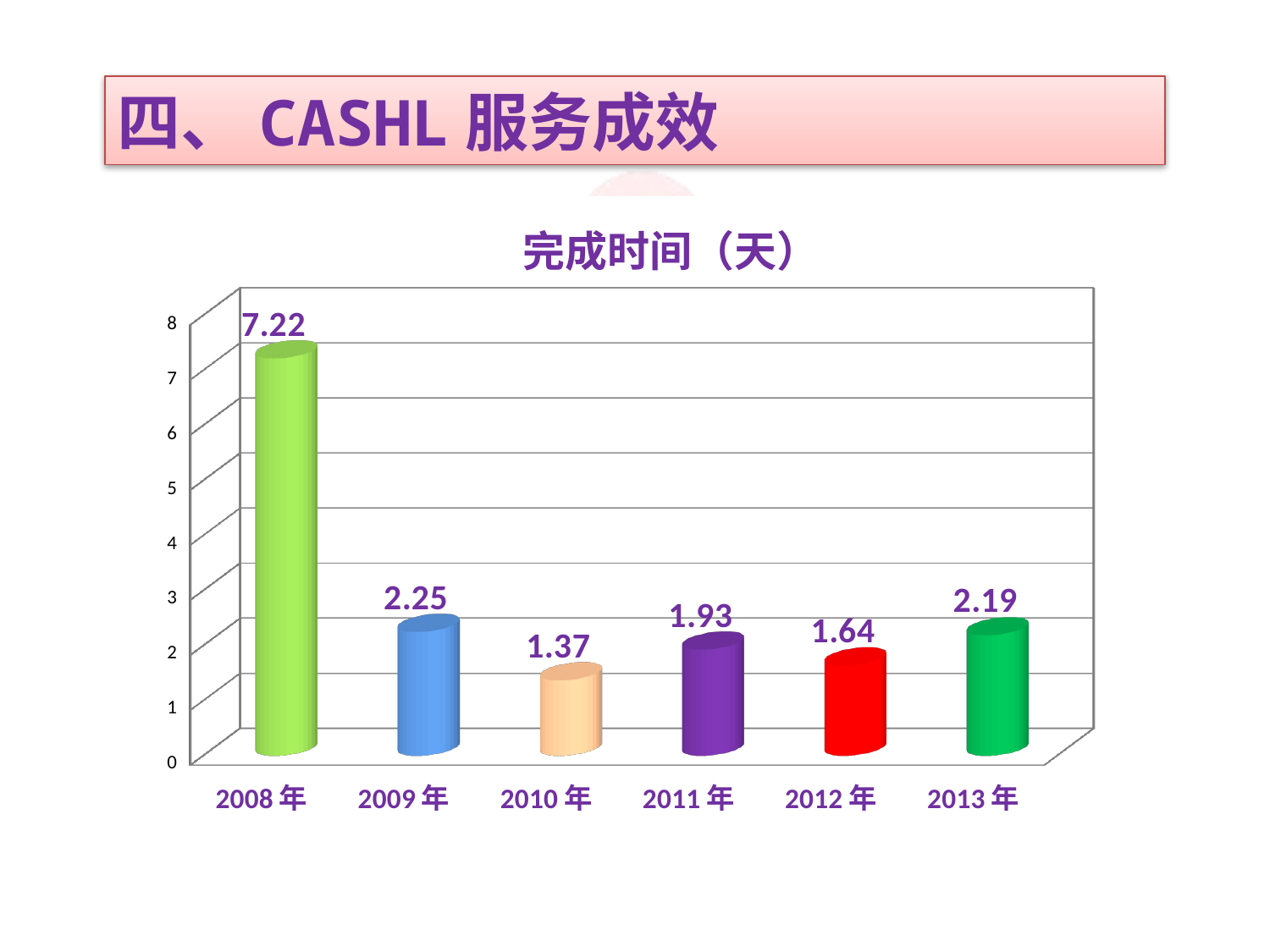
What kind of chart is shown on the slide? bar chart How many years are shown on the x axis? 6 What is the difference between the values for 2011年 and 2012年? 0.29 What is the value for 2008年? 7.22 What is the value for 2013年? 2.19 What is the title of the chart? 完成时间（天） What is the value for 2010年? 1.37 Is the value for 2012年 greater or less than 2? less Which is larger, the value for 2009年 or the value for 2013年? 2009年 Which year has the highest value? 2008年 Which year has the lowest value? 2010年 What is the difference between the values for 2008年 and 2009年? 4.97